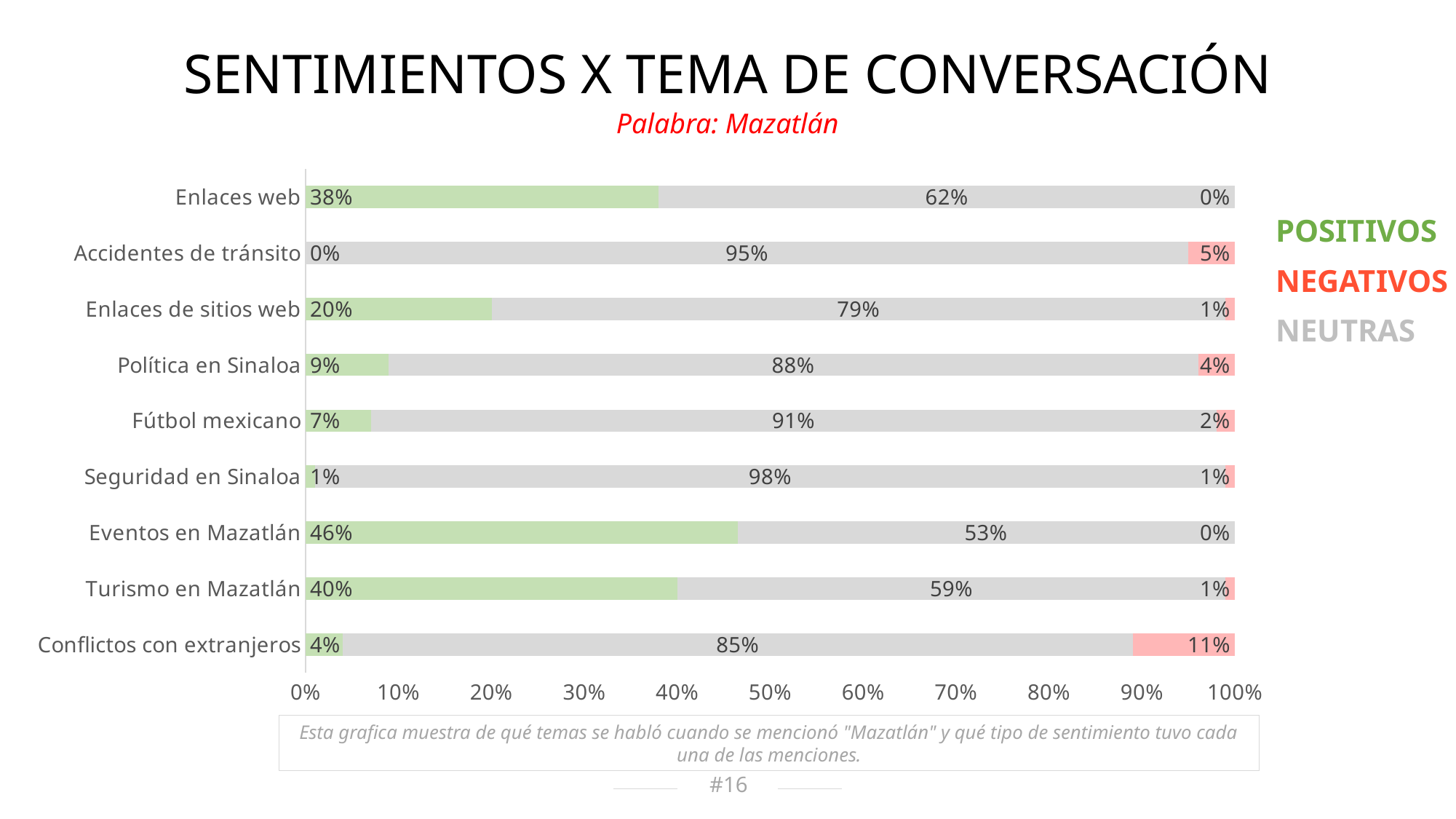
What is the negative (NEGATIVOS) percentage for Conflictos con extranjeros? 11% What is the difference between the positive percentages of Turismo en Mazatlán and Enlaces web? 2% Which has a larger neutral (NEUTRAS) percentage, Accidentes de tránsito or Política en Sinaloa? Accidentes de tránsito What is the neutral (NEUTRAS) percentage for Seguridad en Sinaloa? 98% Which topic has the highest positive (POSITIVOS) percentage? Eventos en Mazatlán How many series does the legend list? 3 What kind of chart is shown on the slide? Stacked bar chart What colour represents the NEGATIVOS series in the chart? Red (pink) How many topics (categories) are shown in the chart? 9 What is the positive (POSITIVOS) percentage for Eventos en Mazatlán? 46% Which topic has the lowest neutral (NEUTRAS) percentage? Eventos en Mazatlán Which topic has the highest negative (NEGATIVOS) percentage? Conflictos con extranjeros